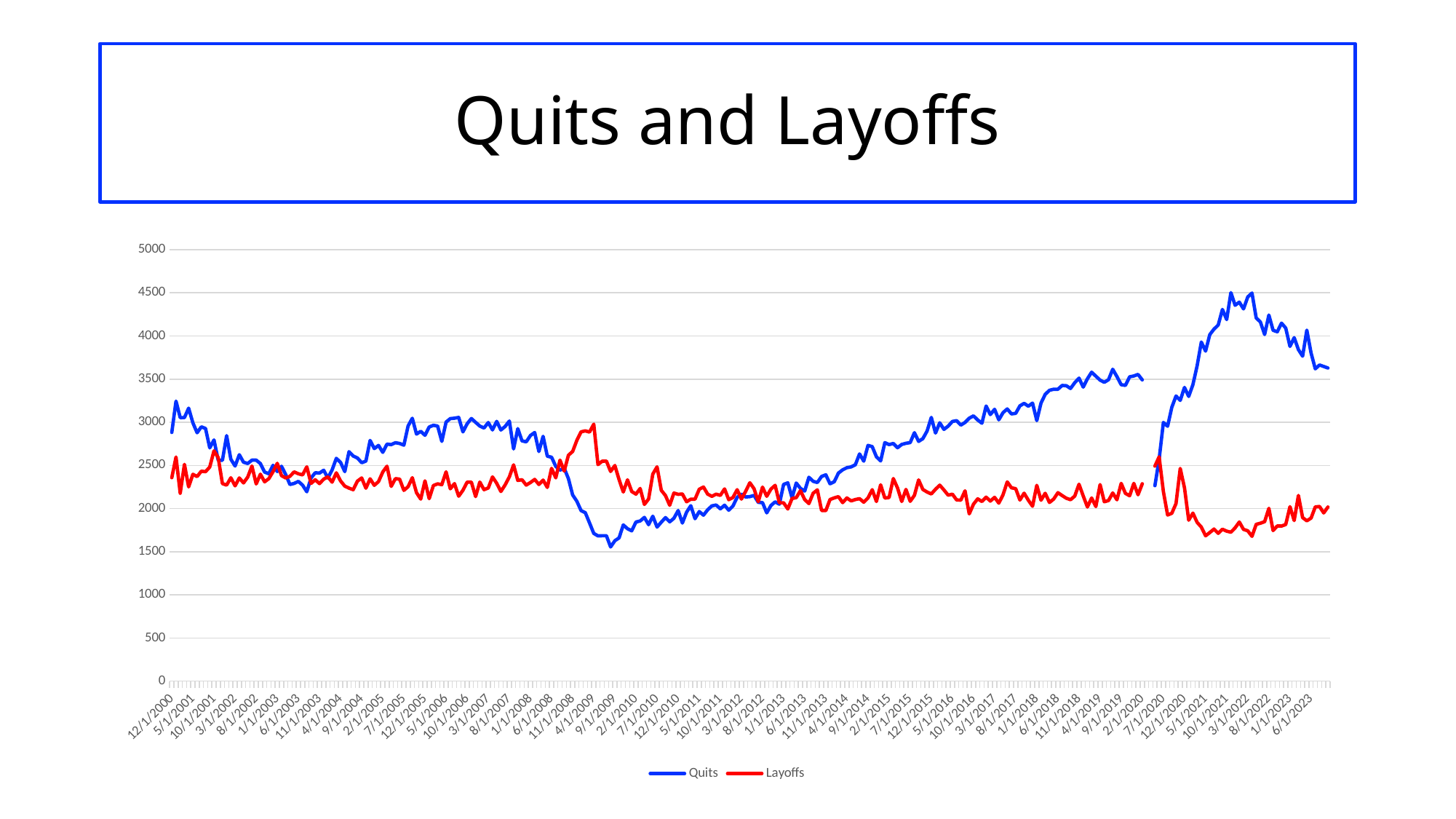
What colour is the Layoffs line? Red Is the value of Layoffs around 4/1/2009 greater or less than 2500? greater What kind of chart is shown on the slide? Line chart Is the peak value of the Quits series in 2022 greater or less than 4000? greater Does the Quits series generally rise or fall between 1/1/2013 and 9/1/2019? Rise Is the value of Quits around 9/1/2009 greater or less than 2000? less How many series does the legend list? 2 Around 4/1/2009, which series has the higher value, Quits or Layoffs? Layoffs Around 3/1/2022, which series has the higher value, Quits or Layoffs? Quits What is the title of the chart? Quits and Layoffs Which series reaches the highest value anywhere on the chart? Quits